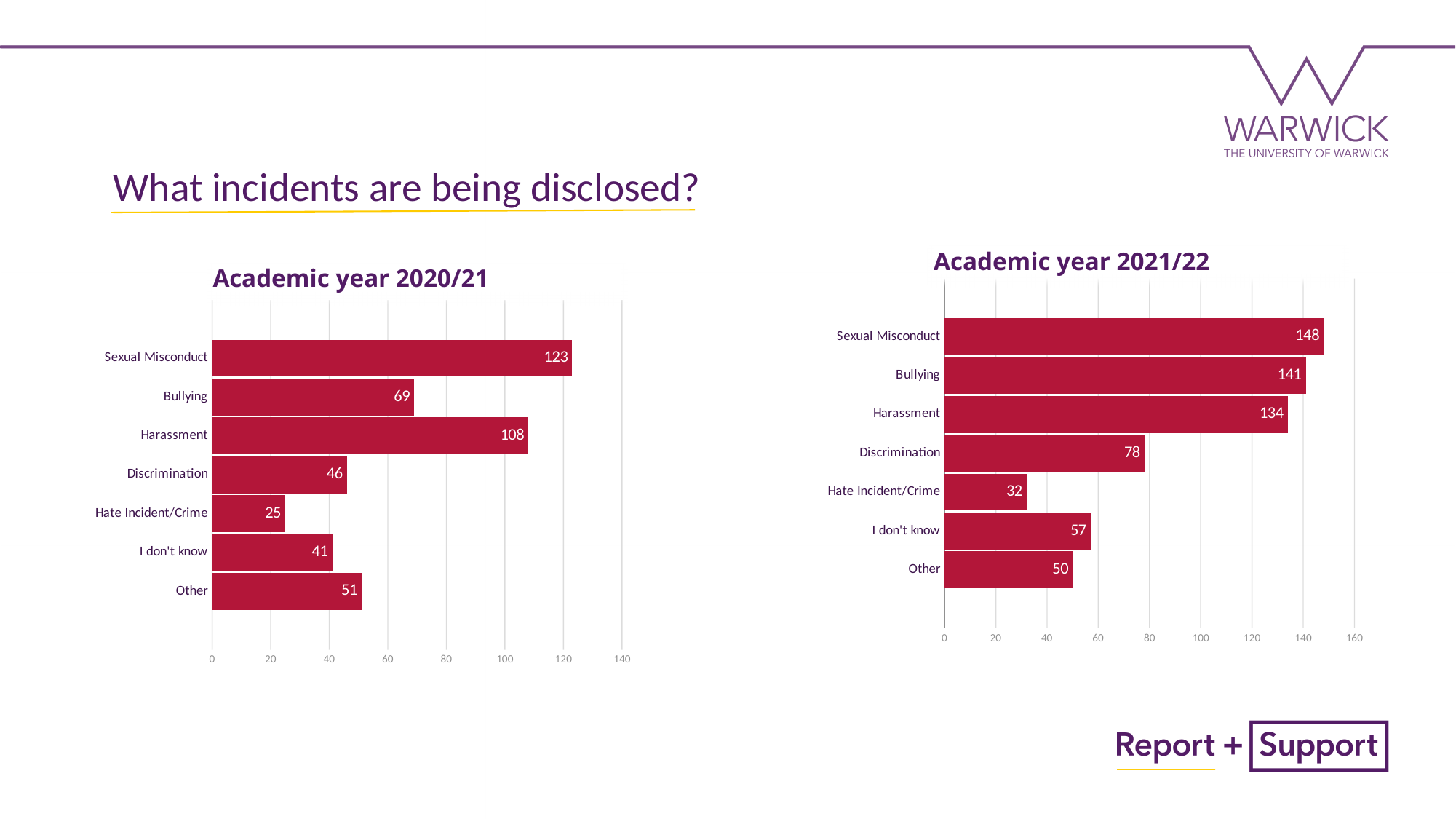
How many categories are shown in the 'Academic year 2021/22' chart? 7 In the 'Academic year 2020/21' chart, what is the value for Harassment? 108 In the 'Academic year 2021/22' chart, is the value for Harassment greater or less than 120? greater In the 'Academic year 2021/22' chart, what is the value for Discrimination? 78 What is the title of the chart on the right side of the slide? Academic year 2021/22 In the 'Academic year 2021/22' chart, which category has the lowest value? Hate Incident/Crime In the 'Academic year 2021/22' chart, what is the difference between Sexual Misconduct and Bullying? 7 In the 'Academic year 2020/21' chart, what is the difference between Other and I don't know? 10 What kind of chart is the 'Academic year 2020/21' chart? Bar chart In the 'Academic year 2020/21' chart, which category has the highest value? Sexual Misconduct In the 'Academic year 2020/21' chart, what is the value for Hate Incident/Crime? 25 In the 'Academic year 2020/21' chart, which is larger: Bullying or Discrimination? Bullying